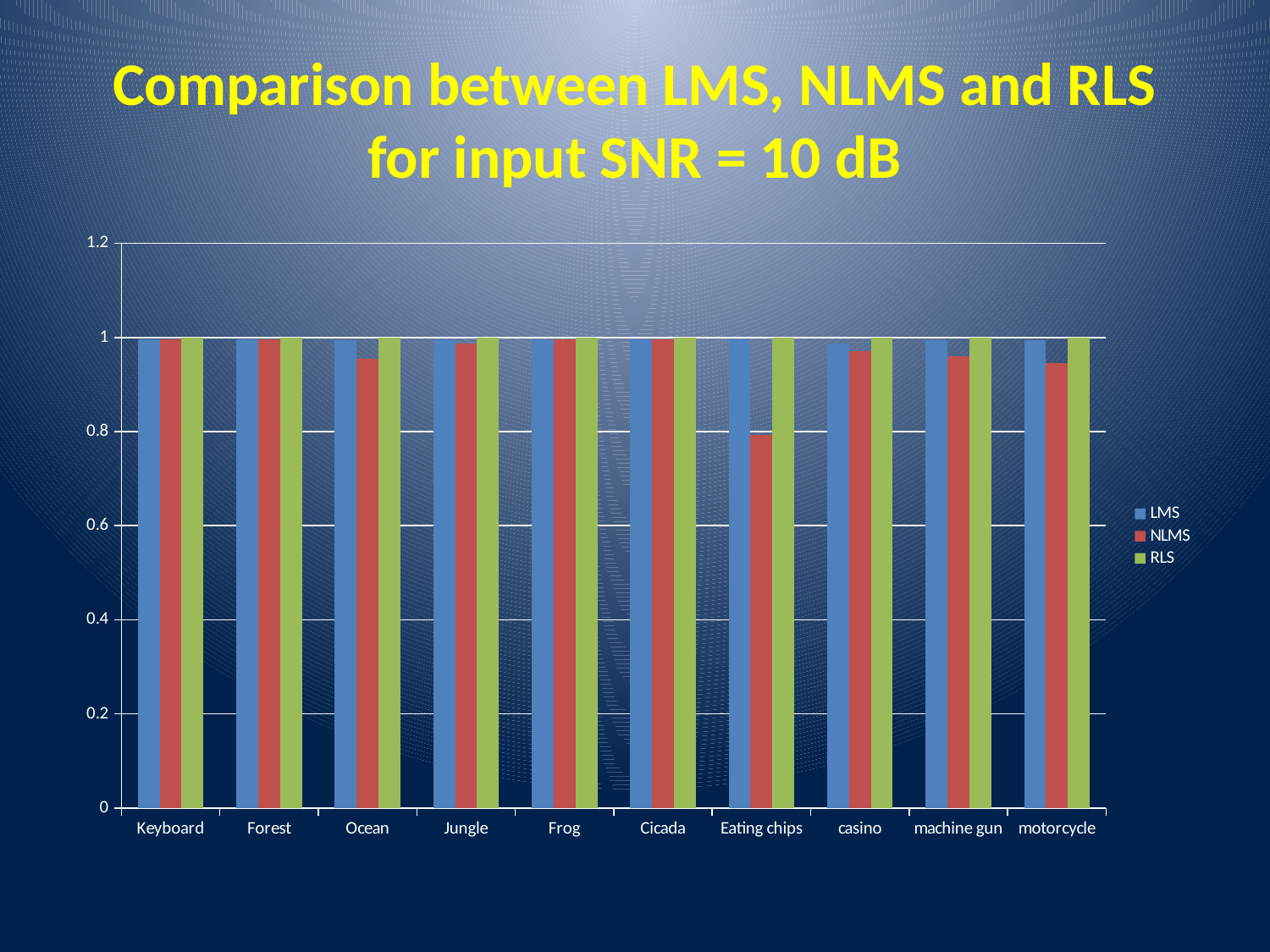
For which category is the NLMS value lowest? Eating chips Which is larger, the NLMS value for Ocean or the NLMS value for Eating chips? Ocean Which is larger for Eating chips, the NLMS value or the RLS value? RLS What is the title of the chart on the slide? Comparison between LMS, NLMS and RLS for input SNR = 10 dB Which series is shown in red in the chart? NLMS How many categories are shown along the x axis of the chart? 10 How many series does the chart's legend list? 3 Is the NLMS value for Eating chips greater or less than 1? less Is the NLMS value for Ocean greater or less than 0.8? greater Is the RLS value for motorcycle greater or less than 0.8? greater What kind of chart is shown on the slide? bar chart